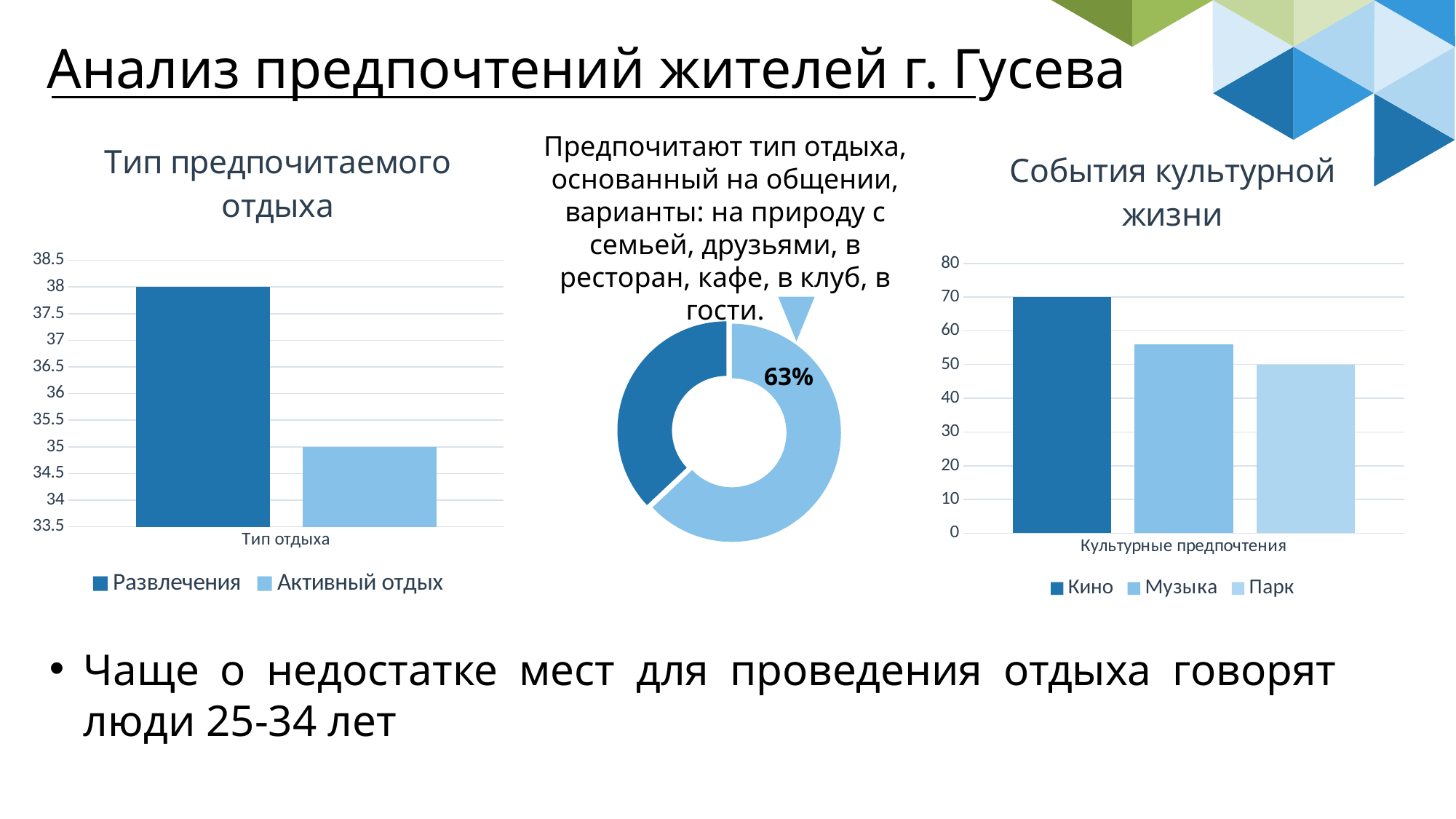
In the chart titled 'Тип предпочитаемого отдыха', what is the value for Развлечения? 38 In the doughnut chart in the middle of the slide, what percentage is printed on the labelled slice? 63% In the chart titled 'События культурной жизни', what is the value for Парк? 50 In the chart titled 'События культурной жизни', is the value for Музыка greater or less than 50? greater In the chart titled 'Тип предпочитаемого отдыха', how many series does the legend list? 2 In the chart titled 'Тип предпочитаемого отдыха', which is larger, Развлечения or Активный отдых? Развлечения In the chart titled 'События культурной жизни', which series has the highest value? Кино What kind of chart is the chart titled 'События культурной жизни'? bar chart In the chart titled 'Тип предпочитаемого отдыха', what is the difference between Развлечения and Активный отдых? 3 In the chart titled 'Тип предпочитаемого отдыха', what is the value for Активный отдых? 35 In the chart titled 'События культурной жизни', what is the value for Кино? 70 In the chart titled 'События культурной жизни', what is the difference between Кино and Парк? 20